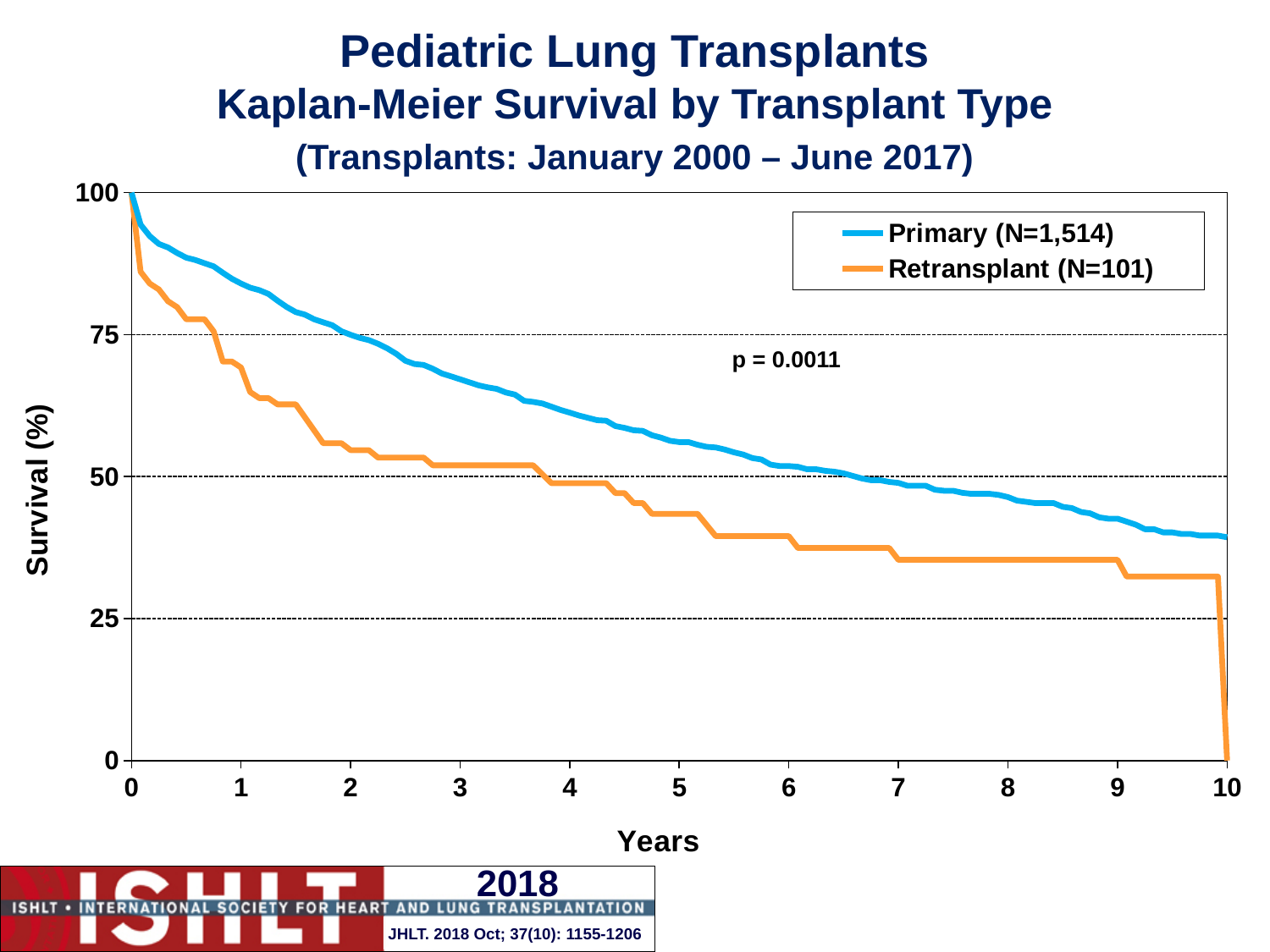
What kind of chart is shown on the slide? Line chart Is the survival value for the Primary series at year 1 greater or less than 75? greater Is the survival value for the Retransplant series at year 5 greater or less than 50? less What p-value is shown on the chart? p = 0.0011 Is the survival value for the Primary series at year 5 greater or less than 50? greater Do the survival values for the Retransplant series rise or fall along the x axis? Fall At year 8, which series has the higher survival, Primary or Retransplant? Primary Do the survival values for the Primary series rise or fall as years increase? Fall How many series does the legend list? 2